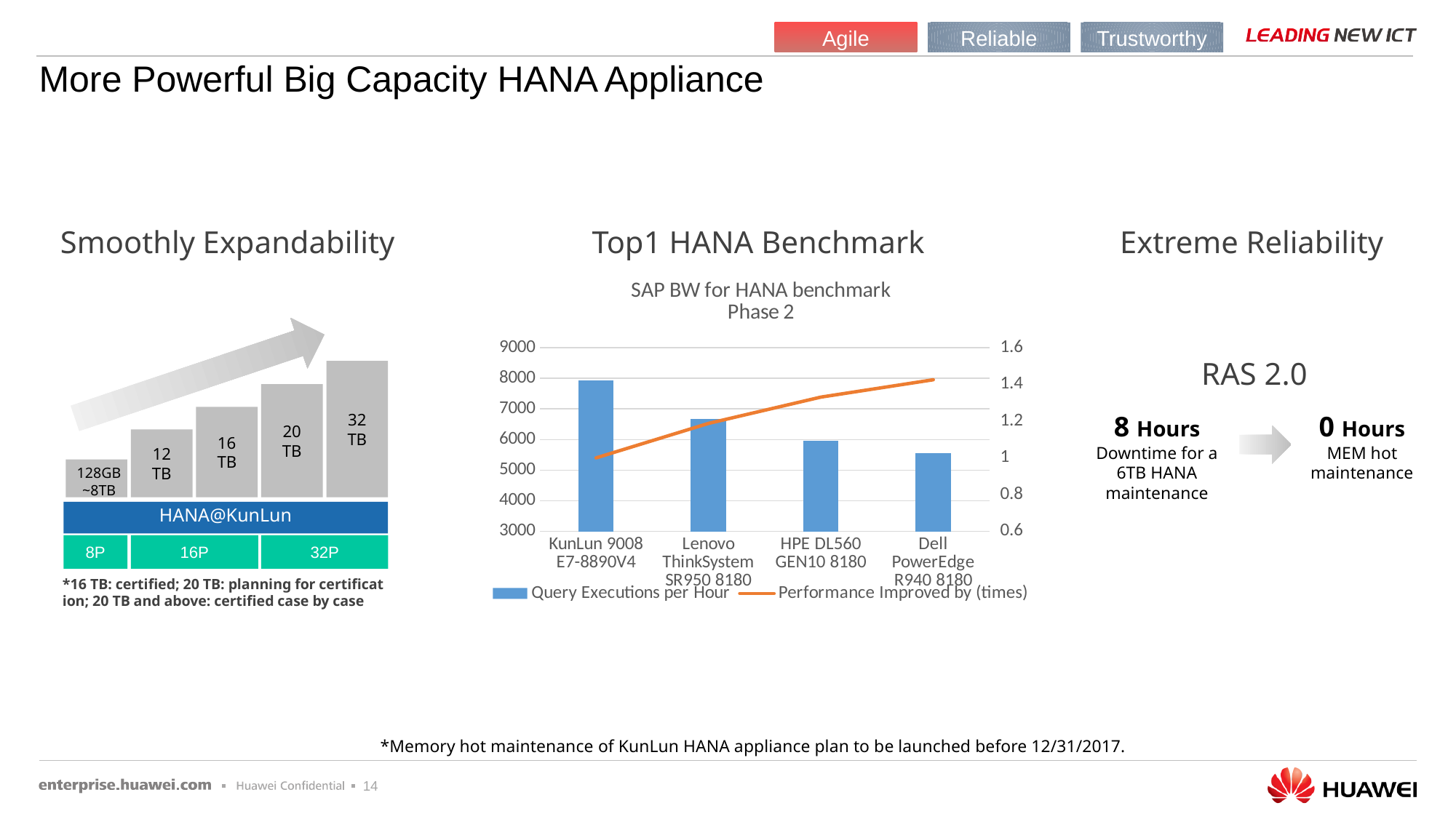
In the SAP BW for HANA benchmark chart, is the Query Executions per Hour value for Dell PowerEdge R940 8180 greater or less than 6000? less What is the title of the chart on the slide? SAP BW for HANA benchmark Phase 2 In the SAP BW for HANA benchmark chart, do the Query Executions per Hour bars rise or fall from left to right? fall In the SAP BW for HANA benchmark chart, does the Performance Improved by (times) line rise or fall from left to right? rise In the SAP BW for HANA benchmark chart, is the Query Executions per Hour value for KunLun 9008 E7-8890V4 greater or less than 7000? greater Which system has the lowest Query Executions per Hour in the SAP BW for HANA benchmark chart? Dell PowerEdge R940 8180 In the SAP BW for HANA benchmark chart, is the Query Executions per Hour value for Lenovo ThinkSystem SR950 8180 greater or less than 6000? greater How many series does the legend of the SAP BW for HANA benchmark chart list? 2 In the SAP BW for HANA benchmark chart, which has more Query Executions per Hour: KunLun 9008 E7-8890V4 or Dell PowerEdge R940 8180? KunLun 9008 E7-8890V4 How many systems are compared along the x axis of the SAP BW for HANA benchmark chart? 4 Which system has the highest Query Executions per Hour in the SAP BW for HANA benchmark chart? KunLun 9008 E7-8890V4